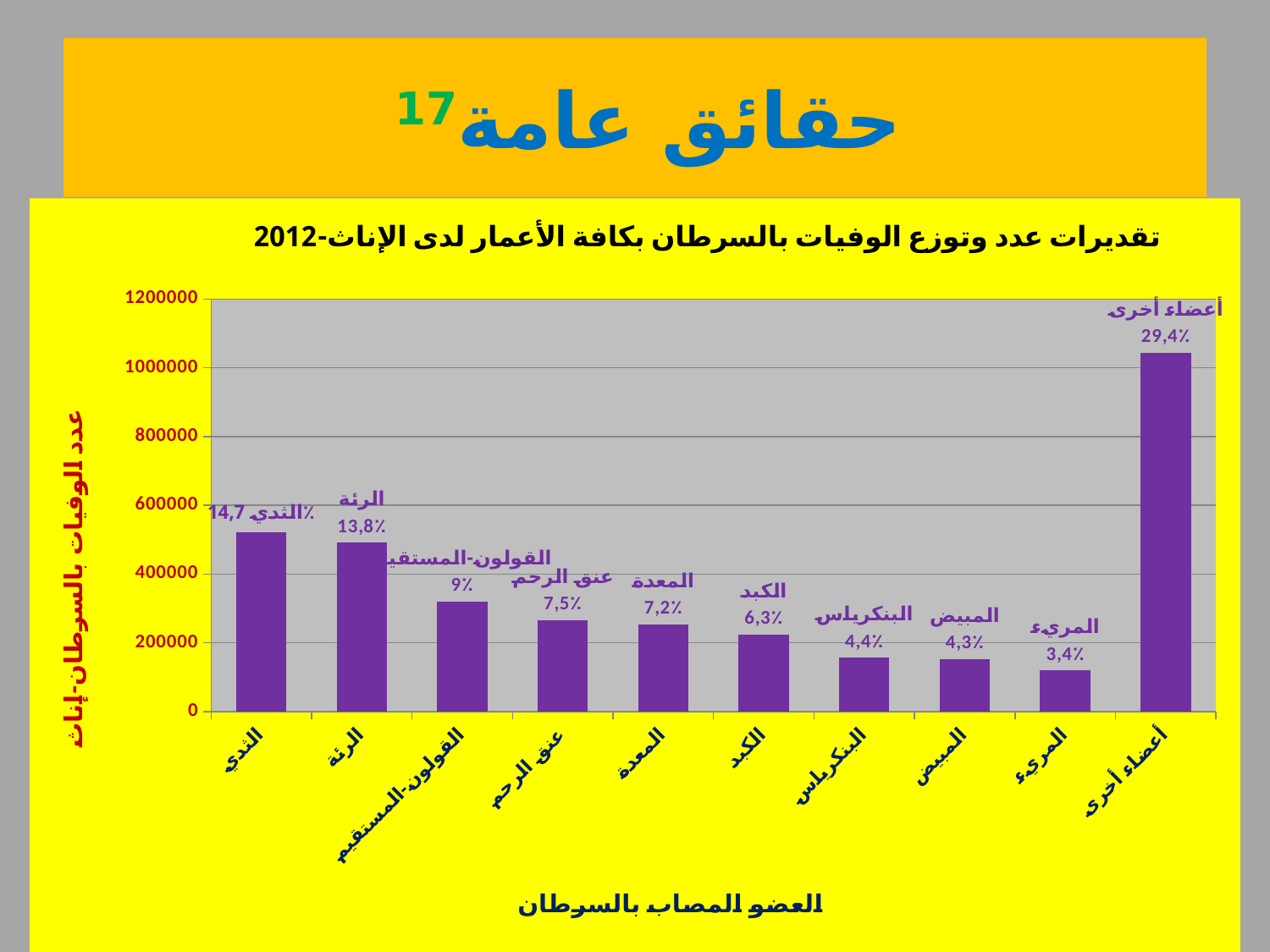
What percentage label is shown for الثدي (breast)? 14,7% Which has a larger percentage label, الكبد (liver) or المعدة (stomach)? المعدة What percentage label is shown for الرئة (lung)? 13,8% What percentage label is shown for المريء (esophagus)? 3,4% Which category has the highest bar in the chart? أعضاء أخرى Which category has the lowest bar in the chart? المريء Is the value for أعضاء أخرى greater or less than 1000000? greater Is the value for الثدي greater or less than 600000? less What type of chart is shown on the slide? bar chart What percentage label is shown for أعضاء أخرى (other organs)? 29,4% How many categories (organs) are plotted on the x axis of the chart? 10 What is the difference between the percentage labels for الثدي and الرئة? 0,9%